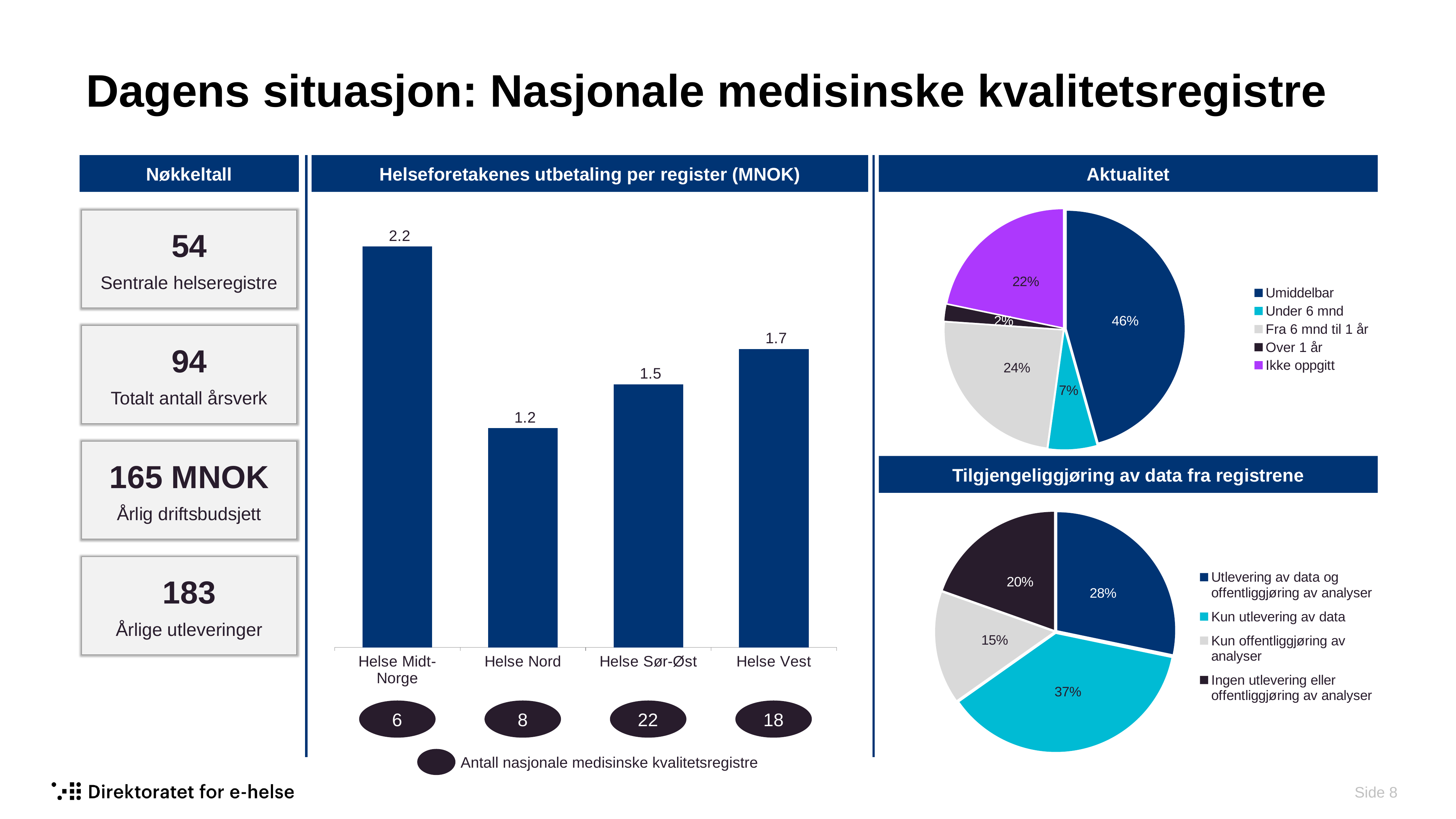
In the 'Aktualitet' pie chart, which category has the smallest share? Over 1 år In the 'Aktualitet' pie chart, what share does 'Umiddelbar' have? 46% In the chart 'Helseforetakenes utbetaling per register (MNOK)', what is the difference between the values for Helse Vest and Helse Sør-Øst? 0.2 How many entries does the legend of the 'Aktualitet' pie chart list? 5 In the chart 'Helseforetakenes utbetaling per register (MNOK)', which category has the lowest value? Helse Nord What kind of chart is 'Helseforetakenes utbetaling per register (MNOK)'? Bar chart In the chart 'Helseforetakenes utbetaling per register (MNOK)', which category has the highest value? Helse Midt-Norge In the 'Tilgjengeliggjøring av data fra registrene' pie chart, which category has the largest share? Kun utlevering av data In the chart 'Helseforetakenes utbetaling per register (MNOK)', which is larger: Helse Nord or Helse Sør-Øst? Helse Sør-Øst How many categories are shown in the chart 'Helseforetakenes utbetaling per register (MNOK)'? 4 In the 'Tilgjengeliggjøring av data fra registrene' pie chart, what share does 'Kun utlevering av data' have? 37% In the chart 'Helseforetakenes utbetaling per register (MNOK)', what is the value for Helse Midt-Norge? 2.2